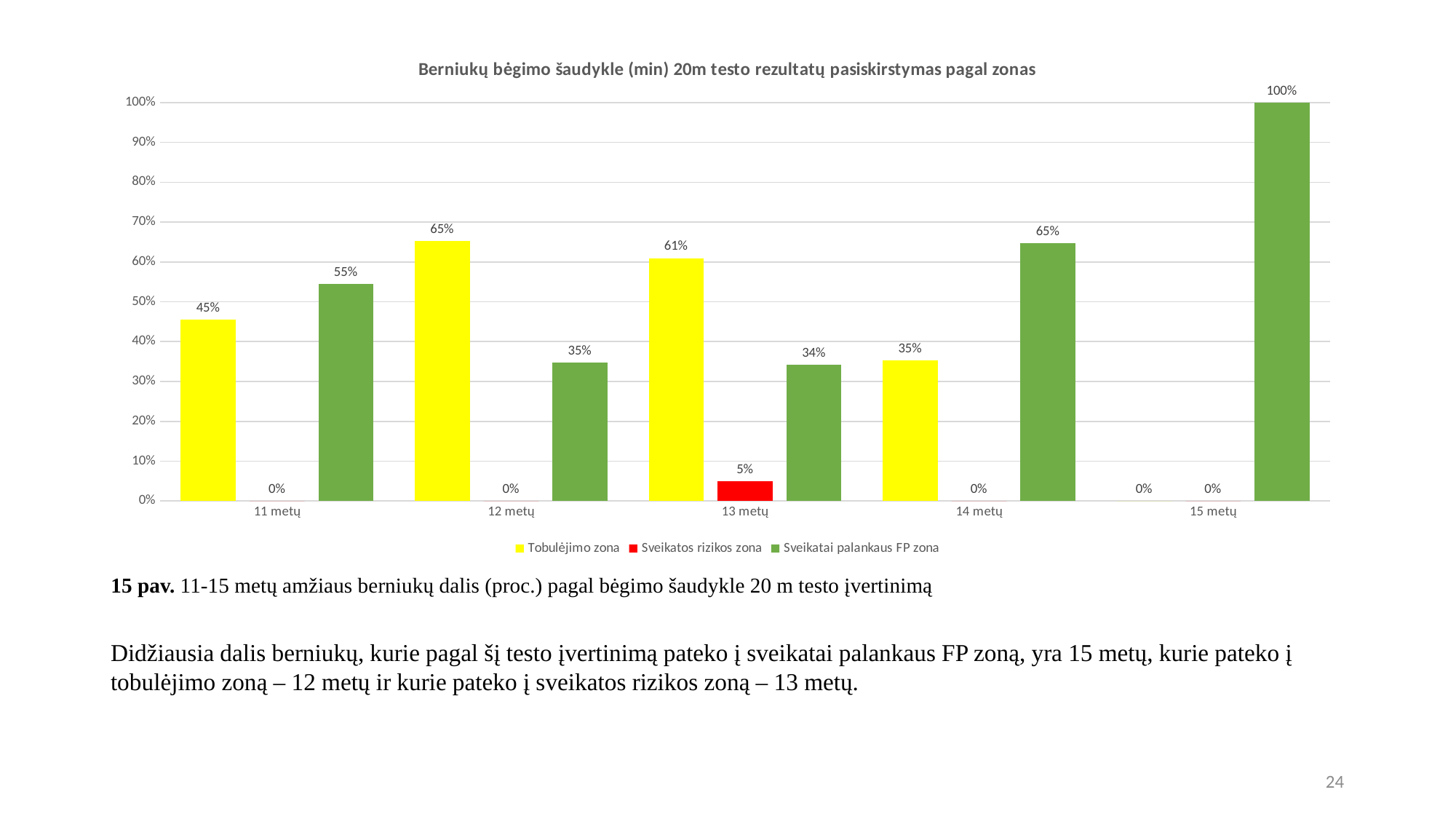
What is the value for Sveikatai palankaus FP zona at 15 metų? 100% What is the value for Sveikatos rizikos zona at 13 metų? 5% Which is larger at 13 metų: Tobulėjimo zona or Sveikatai palankaus FP zona? Tobulėjimo zona Which age group has the highest value for Tobulėjimo zona? 12 metų What is the value for Sveikatai palankaus FP zona at 12 metų? 35% How many series does the legend list? 3 What is the difference between the Sveikatai palankaus FP zona values at 14 metų and 11 metų? 10% How many age groups are shown on the x axis? 5 What colour represents Sveikatos rizikos zona in the chart? Red What kind of chart is shown on the slide? Bar chart What is the value for Tobulėjimo zona at 11 metų? 45% Which age group has the lowest value for Sveikatai palankaus FP zona? 13 metų